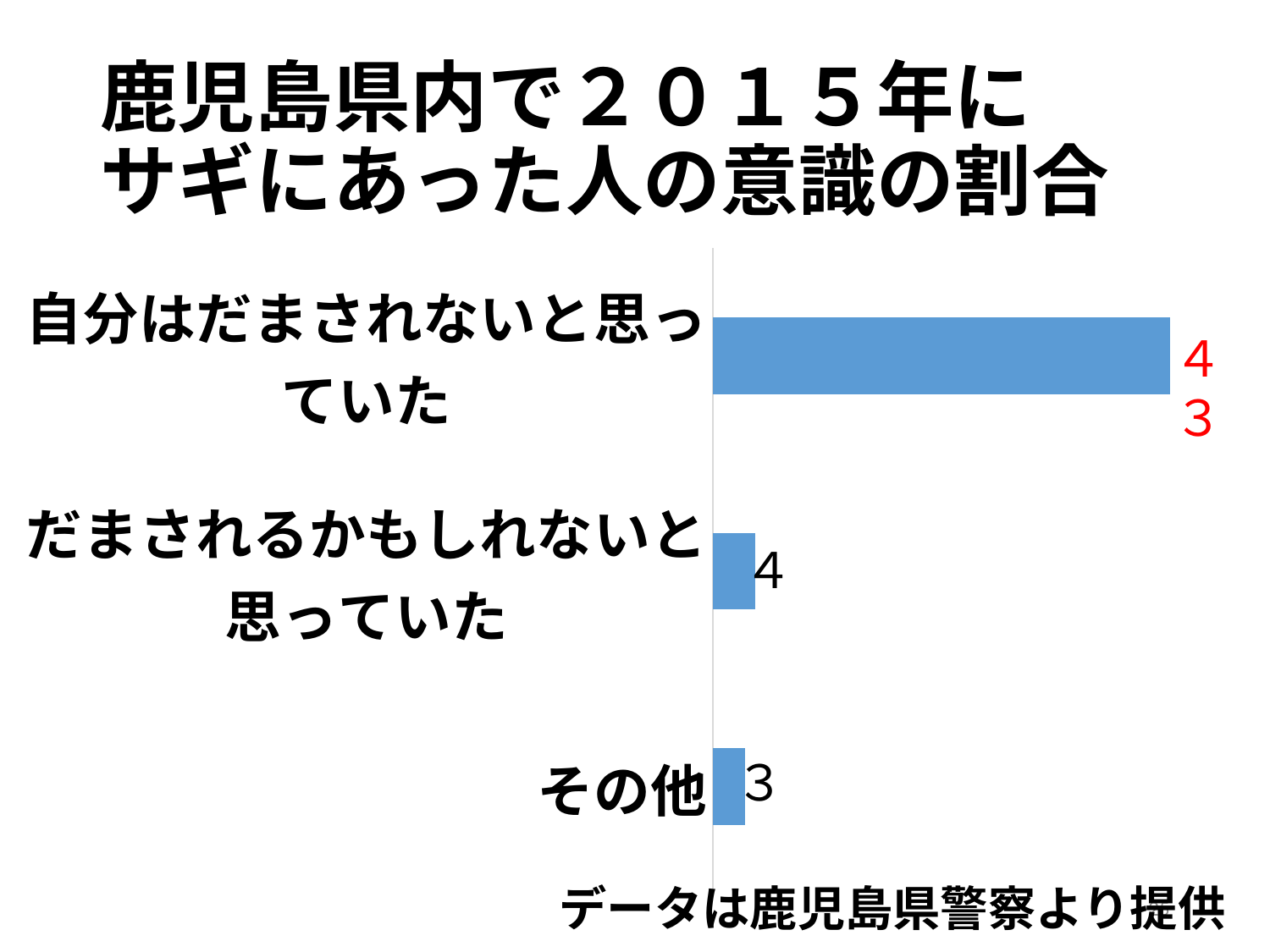
According to the note on the slide, who provided the data? 鹿児島県警察 What is the value for だまされるかもしれないと思っていた? 4 What is the value for その他? 3 What is the value for 自分はだまされないと思っていた? 43 What is the title of the chart? 鹿児島県内で２０１５年にサギにあった人の意識の割合 What is the difference between the values for 自分はだまされないと思っていた and だまされるかもしれないと思っていた? 39 Which category has the highest value? 自分はだまされないと思っていた What is the difference between the values for だまされるかもしれないと思っていた and その他? 1 Which is larger, the value for 自分はだまされないと思っていた or the value for その他? 自分はだまされないと思っていた What kind of chart is shown on the slide? Bar chart How many categories are shown in the chart? 3 Which category has the lowest value? その他